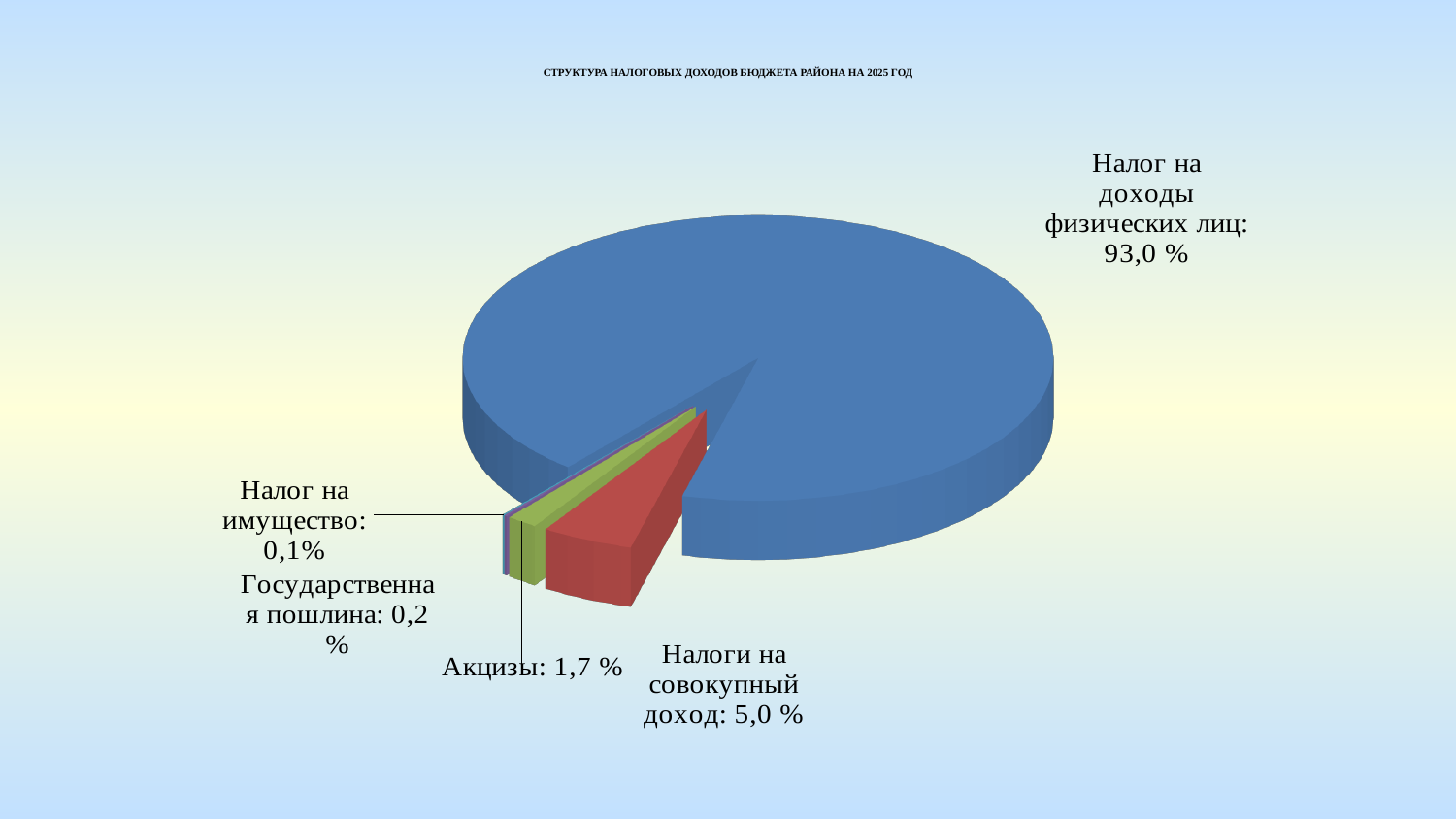
What type of chart is shown on the slide? Pie chart Which category has the smallest share in the pie chart? Налог на имущество How many slices does the pie chart have? 5 What is the title of the chart on the slide? СТРУКТУРА НАЛОГОВЫХ ДОХОДОВ БЮДЖЕТА РАЙОНА НА 2025 ГОД What is the difference in percentage points between Налоги на совокупный доход and Акцизы? 3,3 What is the share of Акцизы in the pie chart? 1,7 % What is the share of Налог на имущество in the pie chart? 0,1% What is the share of Государственная пошлина in the pie chart? 0,2 % Which category has the largest share in the pie chart? Налог на доходы физических лиц Which is larger: the share of Акцизы or the share of Государственная пошлина? Акцизы What is the share of Налоги на совокупный доход in the pie chart? 5,0 % What is the share of Налог на доходы физических лиц in the pie chart? 93,0 %